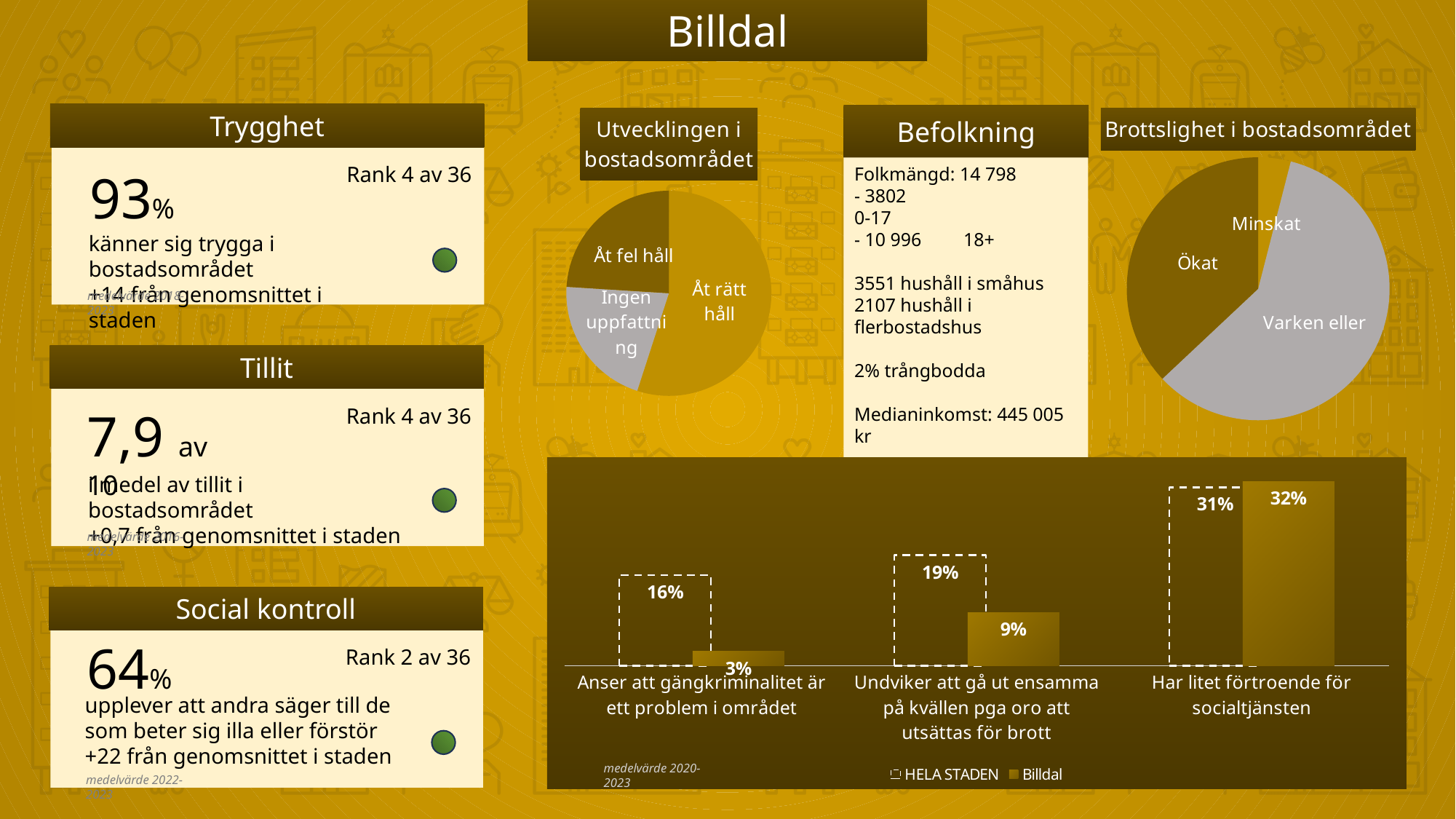
In the bottom bar chart, what is the HELA STADEN value for 'Undviker att gå ut ensamma på kvällen pga oro att utsättas för brott'? 19% In the bottom bar chart, what is the difference between the HELA STADEN and Billdal values for 'Anser att gängkriminalitet är ett problem i området'? 13% In the 'Brottslighet i bostadsområdet' pie chart, which slice is the smallest? Minskat In the bottom bar chart, what is the Billdal value for 'Anser att gängkriminalitet är ett problem i området'? 3% How many slices does the 'Brottslighet i bostadsområdet' pie chart have? 3 In the bottom bar chart, which category has the highest Billdal value? Har litet förtroende för socialtjänsten In the bottom bar chart, how many series does the legend list? 2 In the bottom bar chart, which category has the lowest Billdal value? Anser att gängkriminalitet är ett problem i området What kind of chart is the bottom chart with the legend HELA STADEN and Billdal? bar chart In the bottom bar chart, how many categories are shown on the x axis? 3 In the 'Utvecklingen i bostadsområdet' pie chart, which slice is the largest? Åt rätt håll In the bottom bar chart, what is the Billdal value for 'Har litet förtroende för socialtjänsten'? 32%